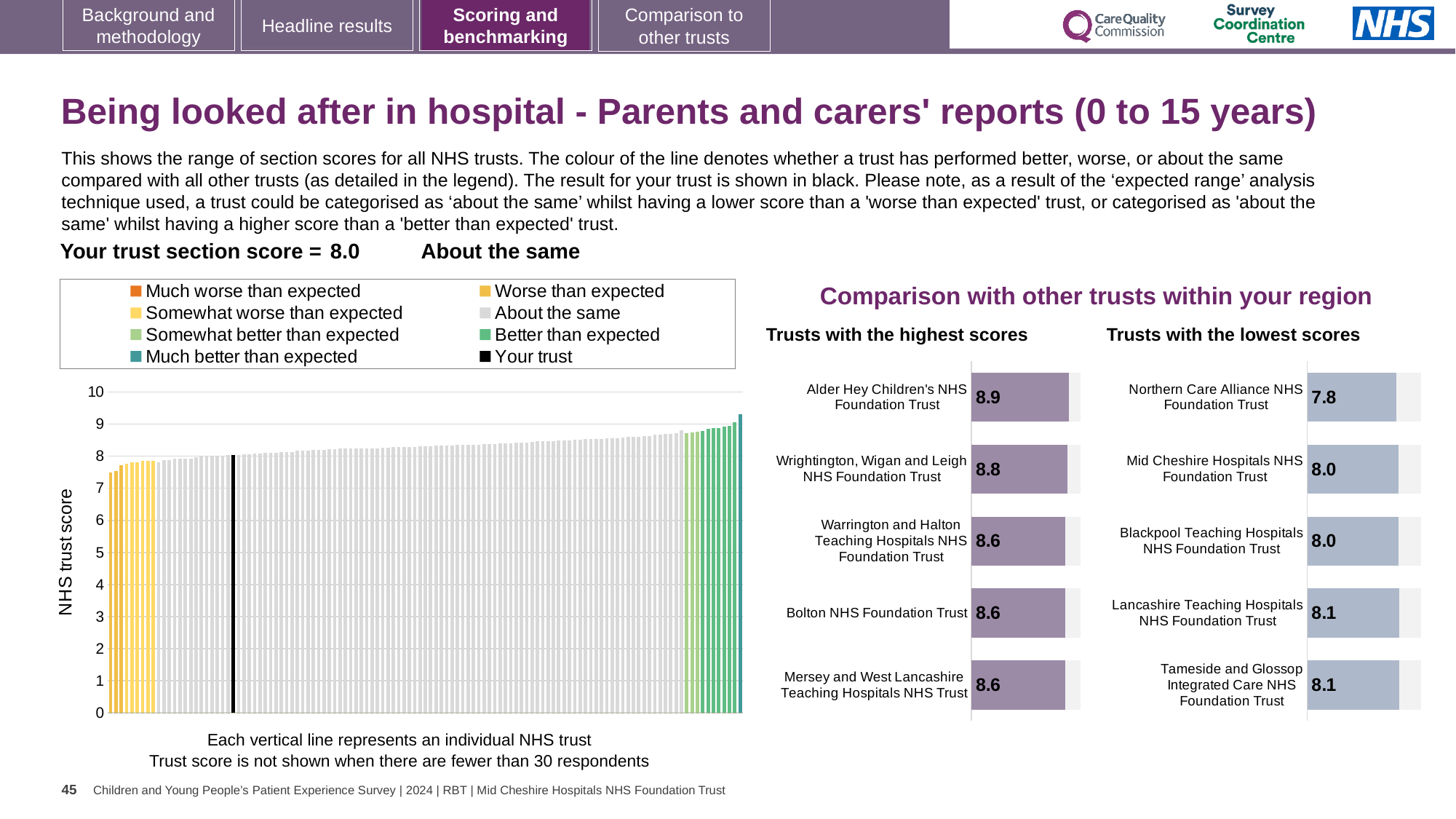
How many entries does the legend above the large chart on the left list? 8 In the 'Trusts with the highest scores' chart, what is the score for Alder Hey Children's NHS Foundation Trust? 8.9 In the 'Trusts with the highest scores' chart, which trust has the highest score? Alder Hey Children's NHS Foundation Trust What is the difference between Alder Hey Children's NHS Foundation Trust's score in the 'Trusts with the highest scores' chart and Northern Care Alliance NHS Foundation Trust's score in the 'Trusts with the lowest scores' chart? 1.1 In the large chart on the left, is the value of the leftmost (lowest) bar greater or less than 8? less In the 'Trusts with the lowest scores' chart, what is the score for Northern Care Alliance NHS Foundation Trust? 7.8 How many trusts are listed in the 'Trusts with the lowest scores' chart? 5 In the 'Trusts with the lowest scores' chart, what is the score for Mid Cheshire Hospitals NHS Foundation Trust? 8.0 In the 'Trusts with the lowest scores' chart, which trust has the lowest score? Northern Care Alliance NHS Foundation Trust In the large chart on the left, do the trust scores rise or fall from left to right? Rise In the 'Trusts with the highest scores' chart, which has the larger score: Alder Hey Children's NHS Foundation Trust or Wrightington, Wigan and Leigh NHS Foundation Trust? Alder Hey Children's NHS Foundation Trust What kind of chart is the large chart on the left showing NHS trust scores? Bar chart